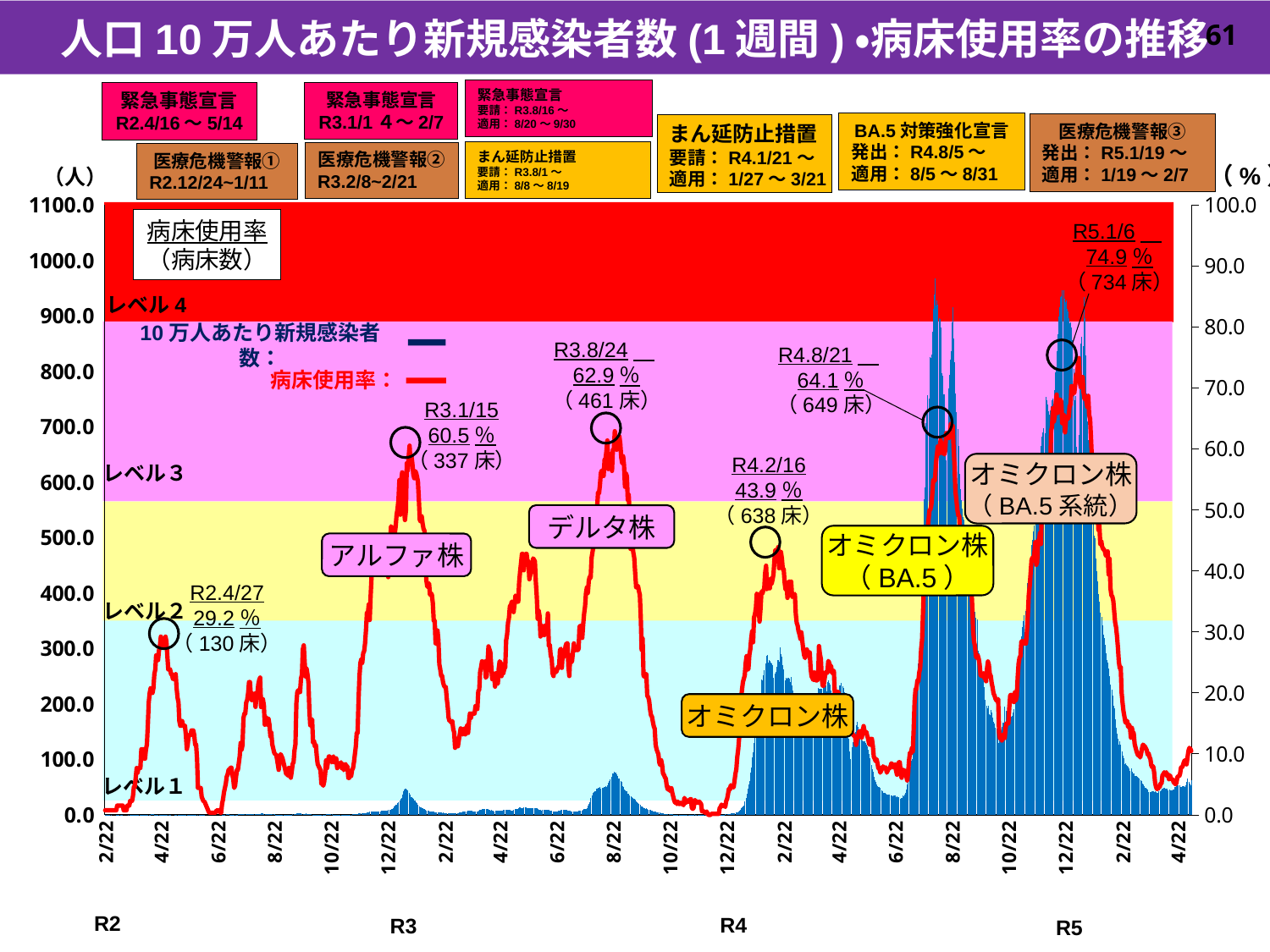
What was the bed occupancy rate (病床使用率) annotated on R5.1/6? 74.9% What kind of chart is this? Combination of a bar chart and a line chart What bed occupancy rate is annotated for R2.4/27? 29.2% Among the annotated bed occupancy rates, which date has the lowest value? R2.4/27 What is the difference between the annotated bed occupancy rates on R4.8/21 and R3.8/24? 1.2% Which series is drawn in red according to the legend? 病床使用率 What bed occupancy rate is annotated for R4.2/16? 43.9% Among the annotated bed occupancy rates, which date has the highest value? R5.1/6 How many series does the legend list? 2 How many beds (床) are shown in the annotation for R3.8/24? 461床 Which is larger, the annotated bed occupancy rate on R3.1/15 or on R4.2/16? R3.1/15 What is the difference in bed count between the R5.1/6 annotation (734床) and the R4.8/21 annotation (649床)? 85床